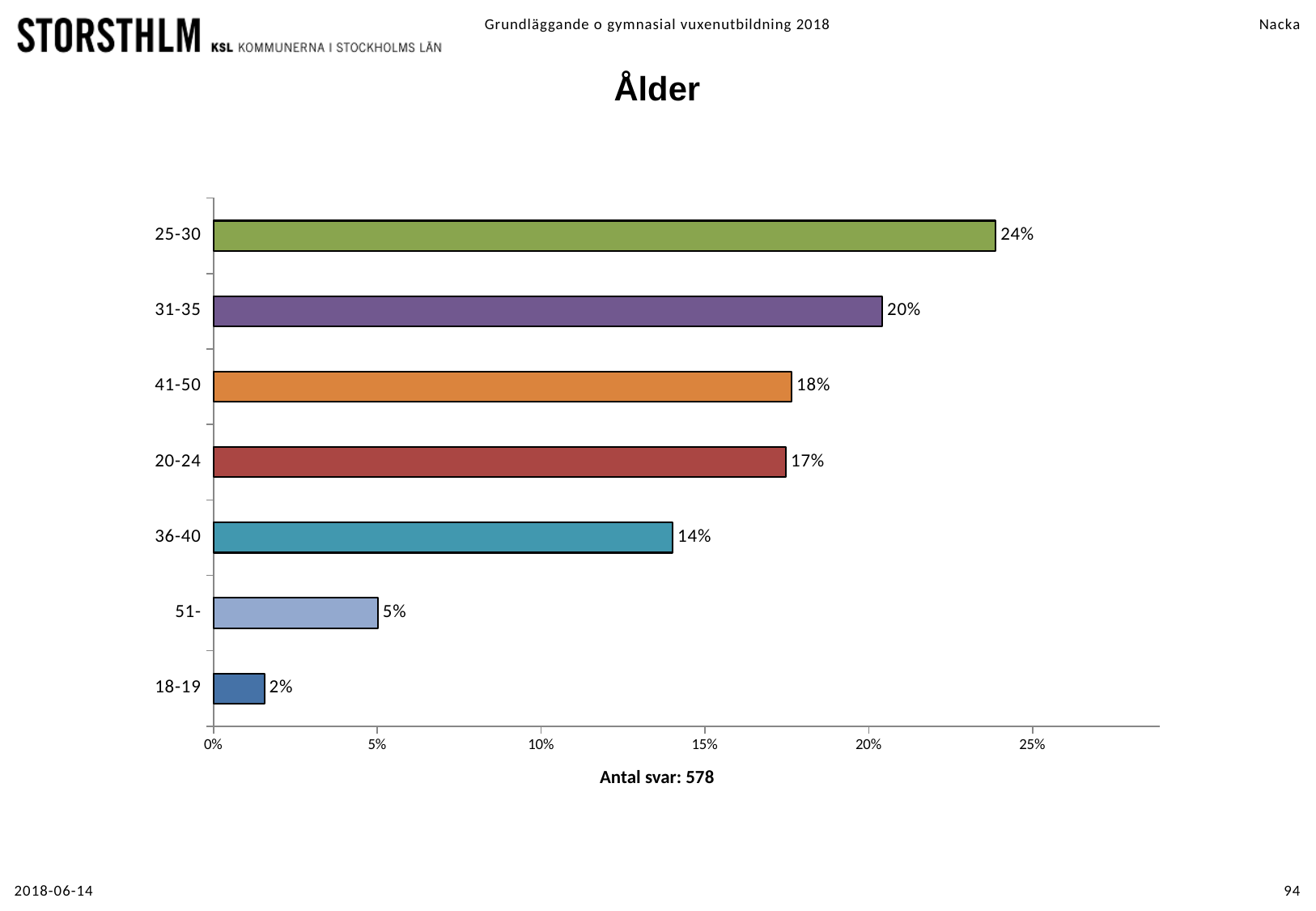
What is the difference between the values for 31-35 and 41-50? 2% Which age group has the lowest value? 18-19 Which is larger, the value for 20-24 or the value for 36-40? 20-24 What is the value for the 25-30 age group? 24% What is the value for the 36-40 age group? 14% What is the value for the 51- age group? 5% What kind of chart is shown on the slide? Bar chart Is the value for 31-35 greater or less than 15%? greater Which age group has the highest value? 25-30 What is the title of the chart? Ålder What is the difference between the values for 25-30 and 18-19? 22% How many age groups are shown in the chart? 7